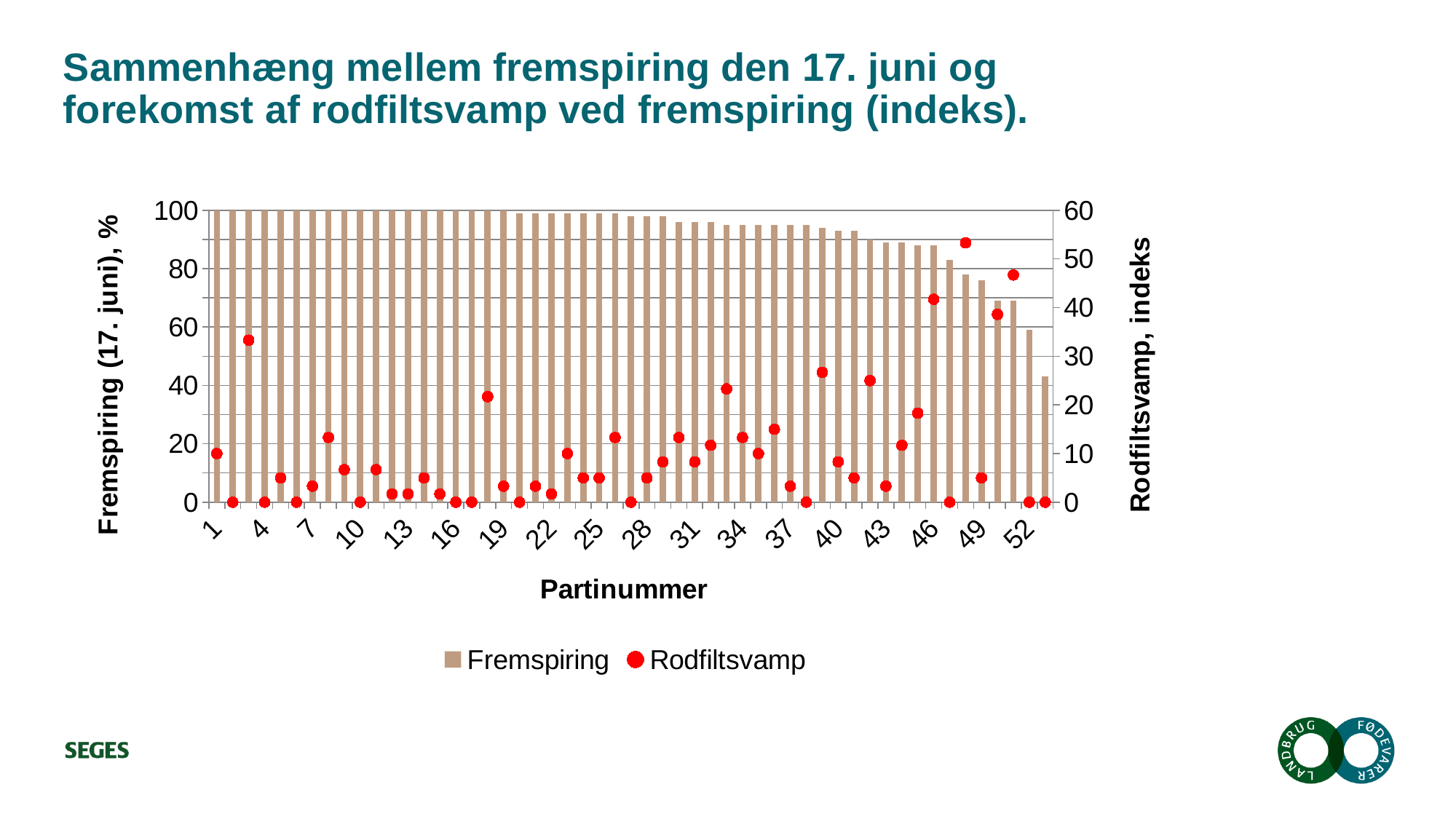
Do the Fremspiring bars rise or fall as the Partinummer increases along the x axis? Fall Is the Fremspiring value for Partinummer 49 greater or less than 80? less Is the Rodfiltsvamp index for Partinummer 51 greater or less than 40? greater Is the Rodfiltsvamp index for Partinummer 3 greater or less than 30? greater Which Partinummer has the highest Rodfiltsvamp index? 48 What kind of chart is shown on the slide? A combined bar and scatter (point) chart What is the title of the x axis? Partinummer How many series does the legend list? 2 What are the two series named in the legend? Fremspiring and Rodfiltsvamp